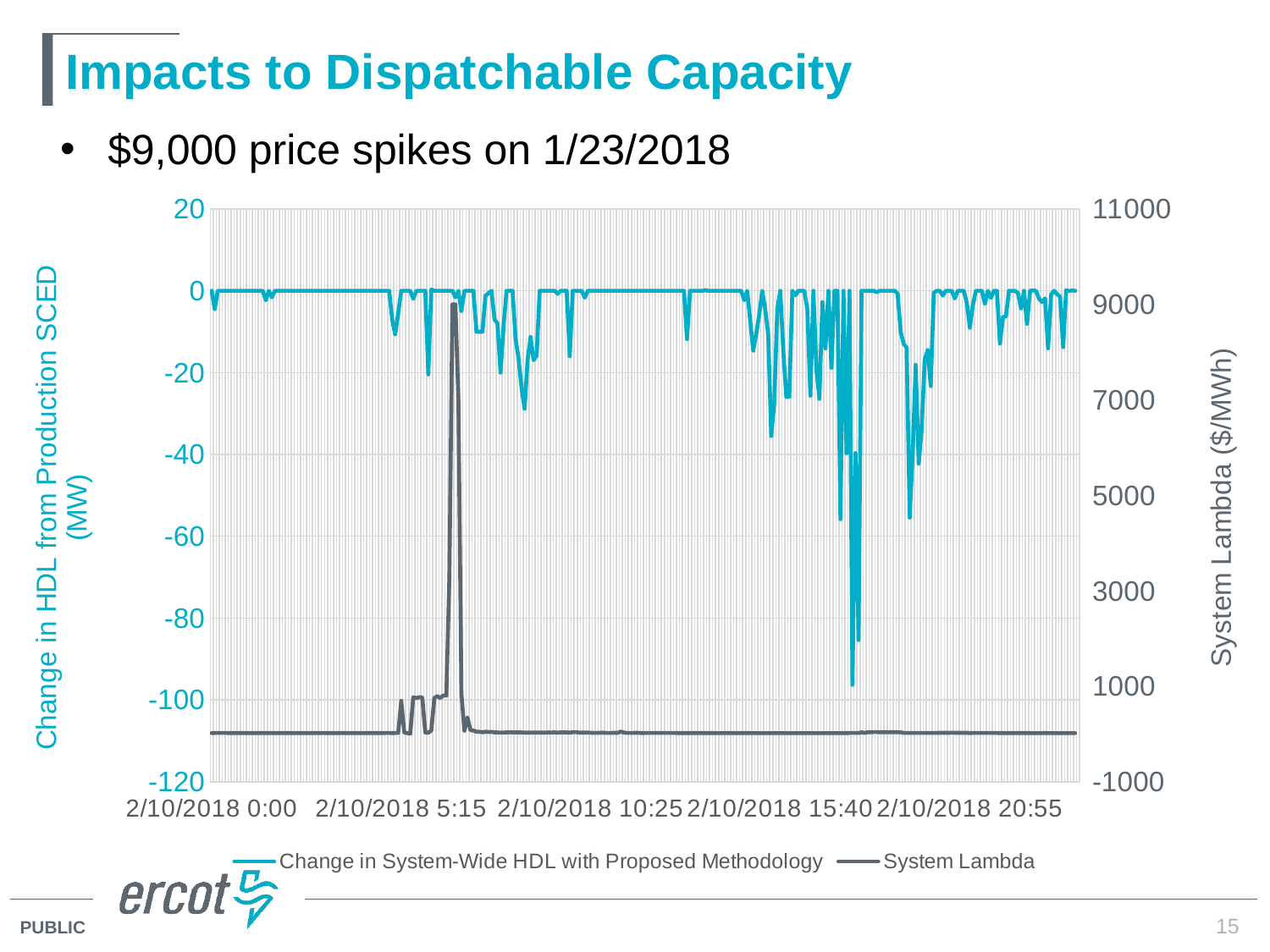
Is the Change in System-Wide HDL value at 2/10/2018 0:00 greater or less than -20 on the left axis? greater What kind of chart is shown on the slide? Line chart What is the lowest tick value shown on the right vertical axis of the chart? -1000 What is the title of the right-hand vertical axis of the chart? System Lambda ($/MWh) What is the highest tick value shown on the left vertical axis of the chart? 20 Is the System Lambda value at 2/10/2018 10:25 greater or less than 1000 on the right axis? less Does the System Lambda series spike before or after the 2/10/2018 5:15 tick on the x axis? after Is the lowest value of the Change in System-Wide HDL series greater or less than -80 on the left axis? less How many date/time labels are shown along the x axis of the chart? 5 How many series does the chart legend list? 2 What are the two series named in the chart legend? Change in System-Wide HDL with Proposed Methodology; System Lambda